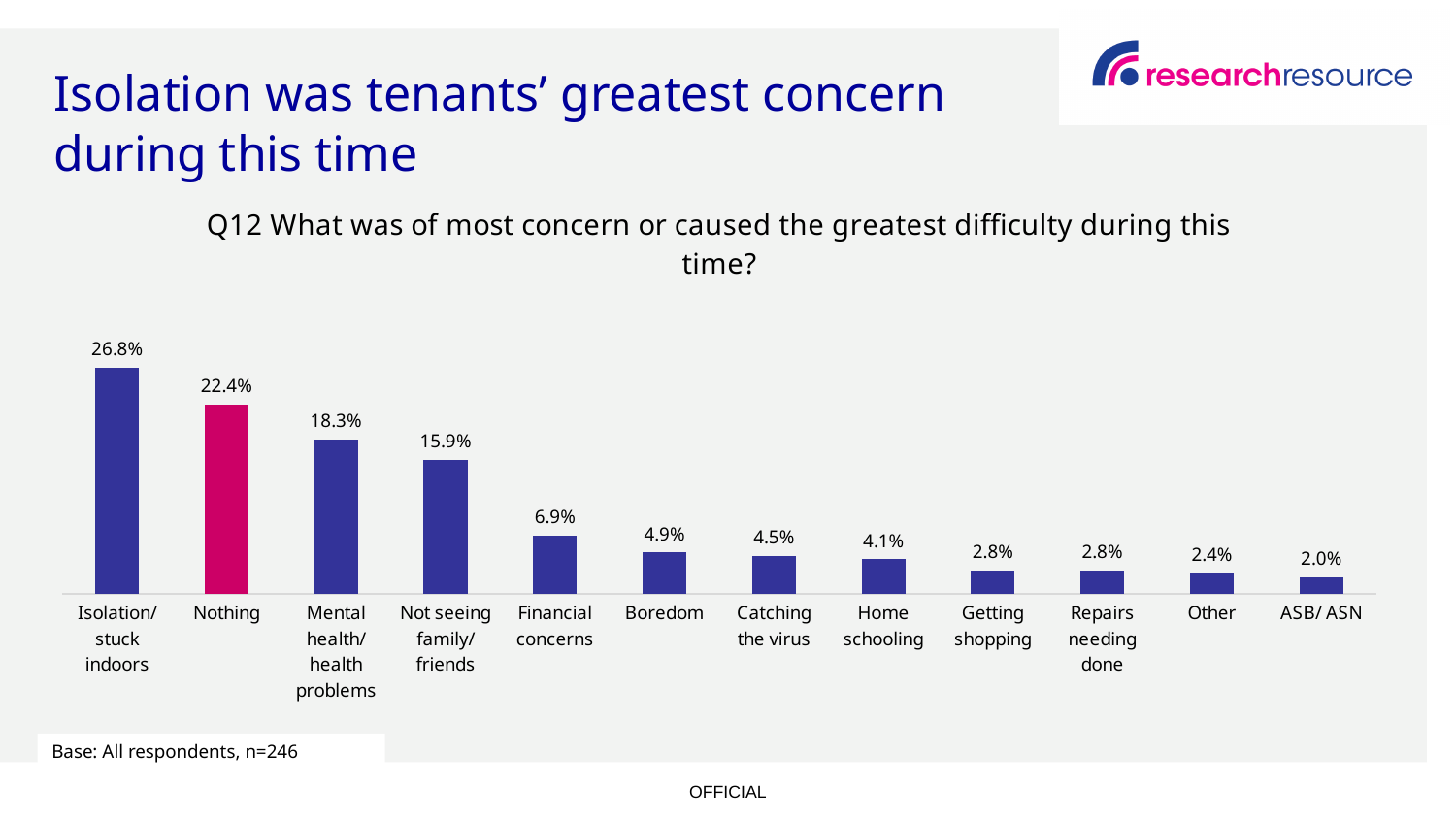
Which category's bar is coloured differently (pink) from the others? Nothing What percentage is shown for 'Financial concerns'? 6.9% Which category has the highest value in the chart? Isolation/stuck indoors What is the value shown for 'Nothing'? 22.4% How many categories are shown in the chart? 12 What percentage of respondents said 'Isolation/stuck indoors' was of most concern? 26.8% What is the difference between the values for 'Isolation/stuck indoors' and 'Nothing'? 4.4% What kind of chart is shown on the slide? Bar chart Which is larger, the value for 'Boredom' or the value for 'Catching the virus'? Boredom What is the base (number of respondents) stated for the chart? n=246 Which category has the lowest value in the chart? ASB/ASN Do the values rise or fall moving from left to right along the x axis? Fall